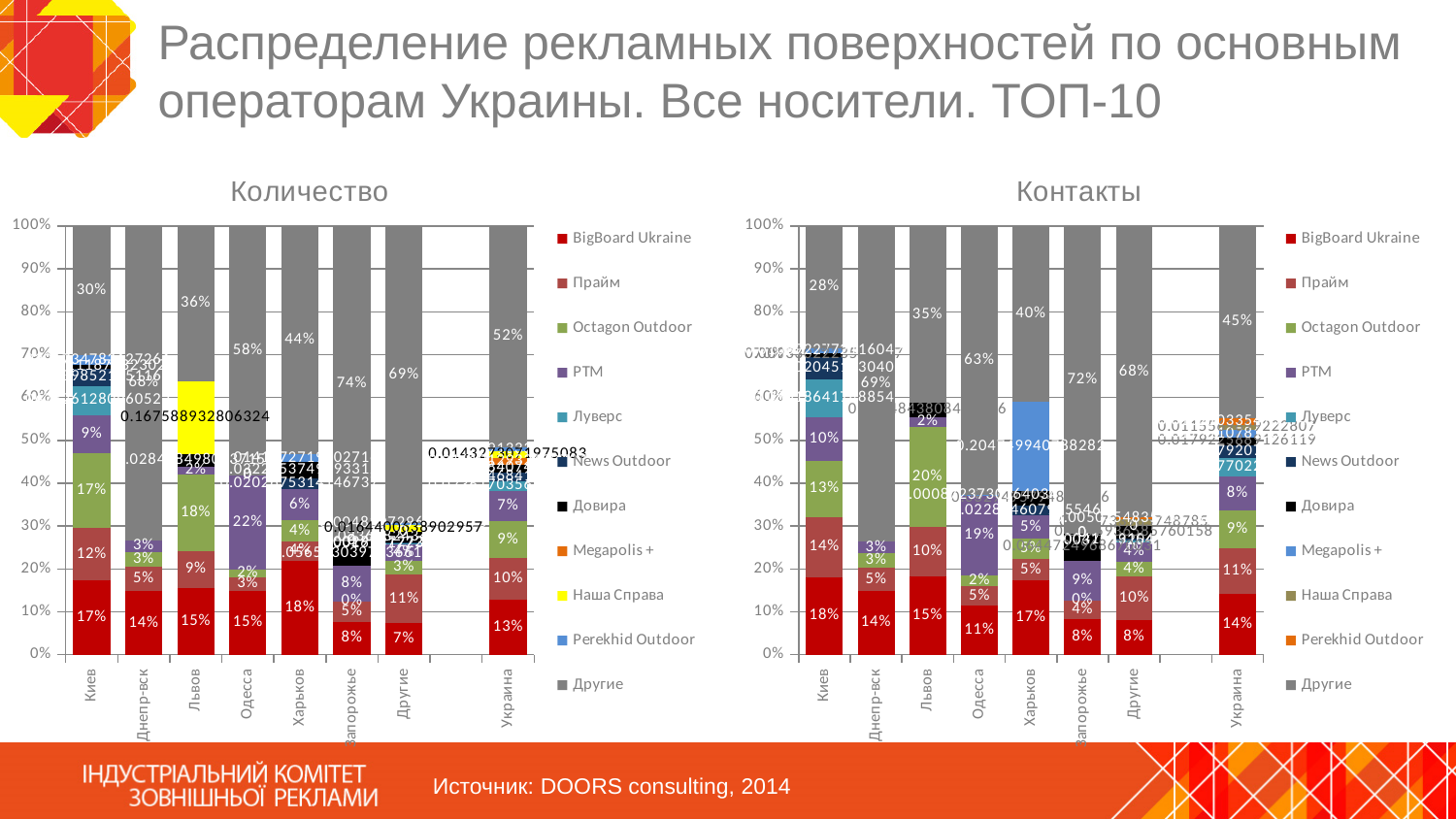
In the "Количество" chart, what is the share of Другие for Запорожье? 74% In the "Количество" chart, which category has the highest share for BigBoard Ukraine? Харьков In the "Контакты" chart, which category has the lowest share for Другие? Киев In the "Контакты" chart, what is the share of Другие for Украина? 45% How many series does the legend of the "Контакты" chart list? 11 In the "Контакты" chart, what is the share of Octagon Outdoor for Львов? 20% In the "Количество" chart, what is the share of BigBoard Ukraine for Киев? 17% In the "Количество" chart, what is the share of РТМ for Одесса? 22% In the "Количество" chart, what is the difference between the Другие share for Одесса and for Киев? 28% In the "Контакты" chart, which is larger: the Прайм share for Киев or for Львов? Киев How many categories are shown on the x axis of the "Количество" chart? 8 In the "Контакты" chart, what is the share of BigBoard Ukraine for Харьков? 17%